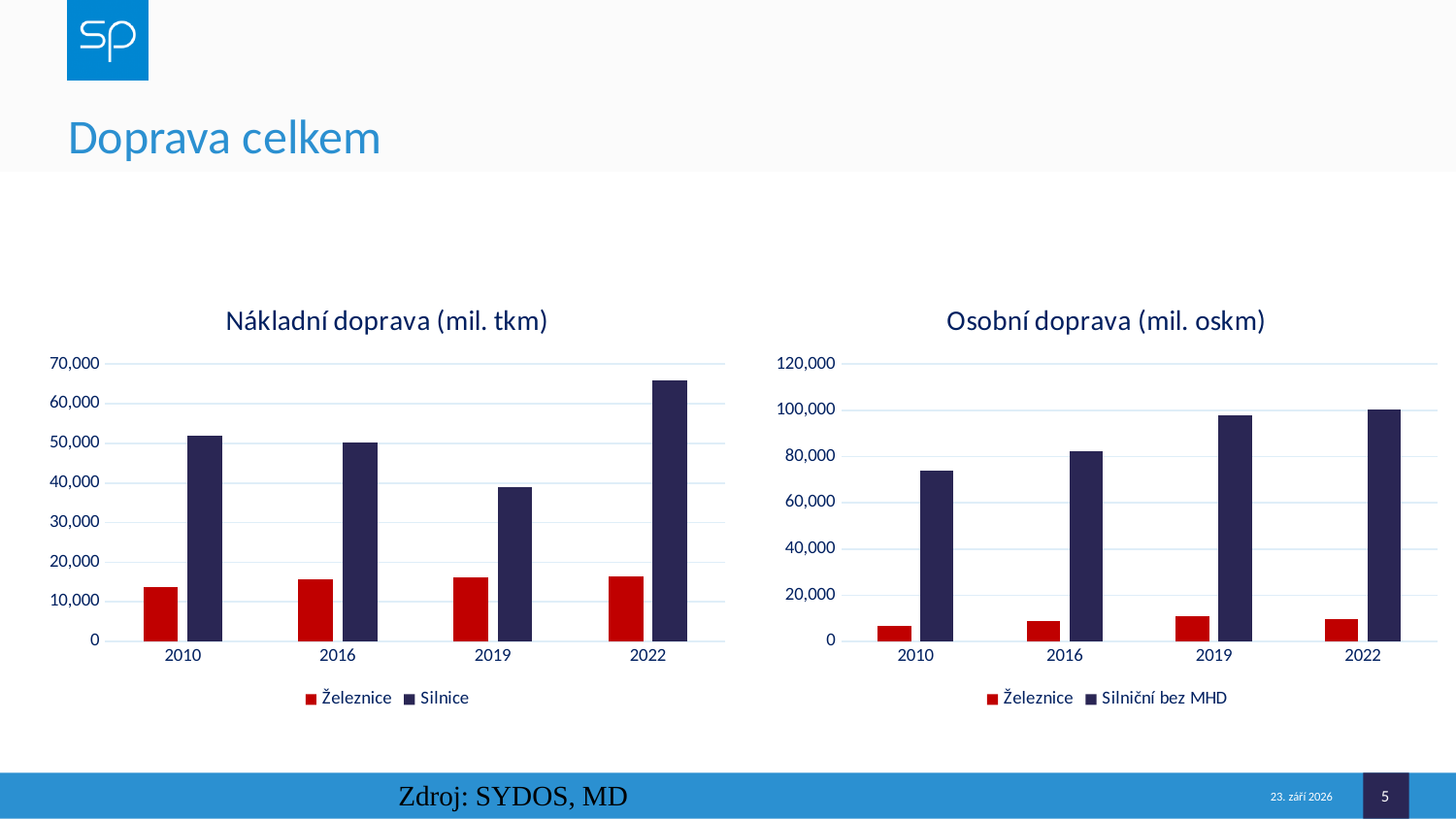
In the 'Nákladní doprava (mil. tkm)' chart, which year has the highest Silnice value? 2022 In the 'Osobní doprava (mil. oskm)' chart, do the Silniční bez MHD values rise or fall from 2010 to 2022? rise In the 'Nákladní doprava (mil. tkm)' chart, is the Železnice value for 2010 greater or less than 20,000? less What are the two legend entries of the 'Osobní doprava (mil. oskm)' chart? Železnice and Silniční bez MHD In the 'Nákladní doprava (mil. tkm)' chart, is the Silnice value for 2022 greater or less than 60,000? greater In the 'Osobní doprava (mil. oskm)' chart, is the Silniční bez MHD value for 2019 greater or less than 80,000? greater How many years are shown on the x axis of the 'Osobní doprava (mil. oskm)' chart? 4 In the 'Nákladní doprava (mil. tkm)' chart, which year has the lowest Silnice value? 2019 What kind of chart is the 'Nákladní doprava (mil. tkm)' chart? bar chart How many series does the legend of the 'Nákladní doprava (mil. tkm)' chart list? 2 In the 'Osobní doprava (mil. oskm)' chart, which is larger in 2016: Železnice or Silniční bez MHD? Silniční bez MHD In the 'Osobní doprava (mil. oskm)' chart, which year has the lowest Silniční bez MHD value? 2010